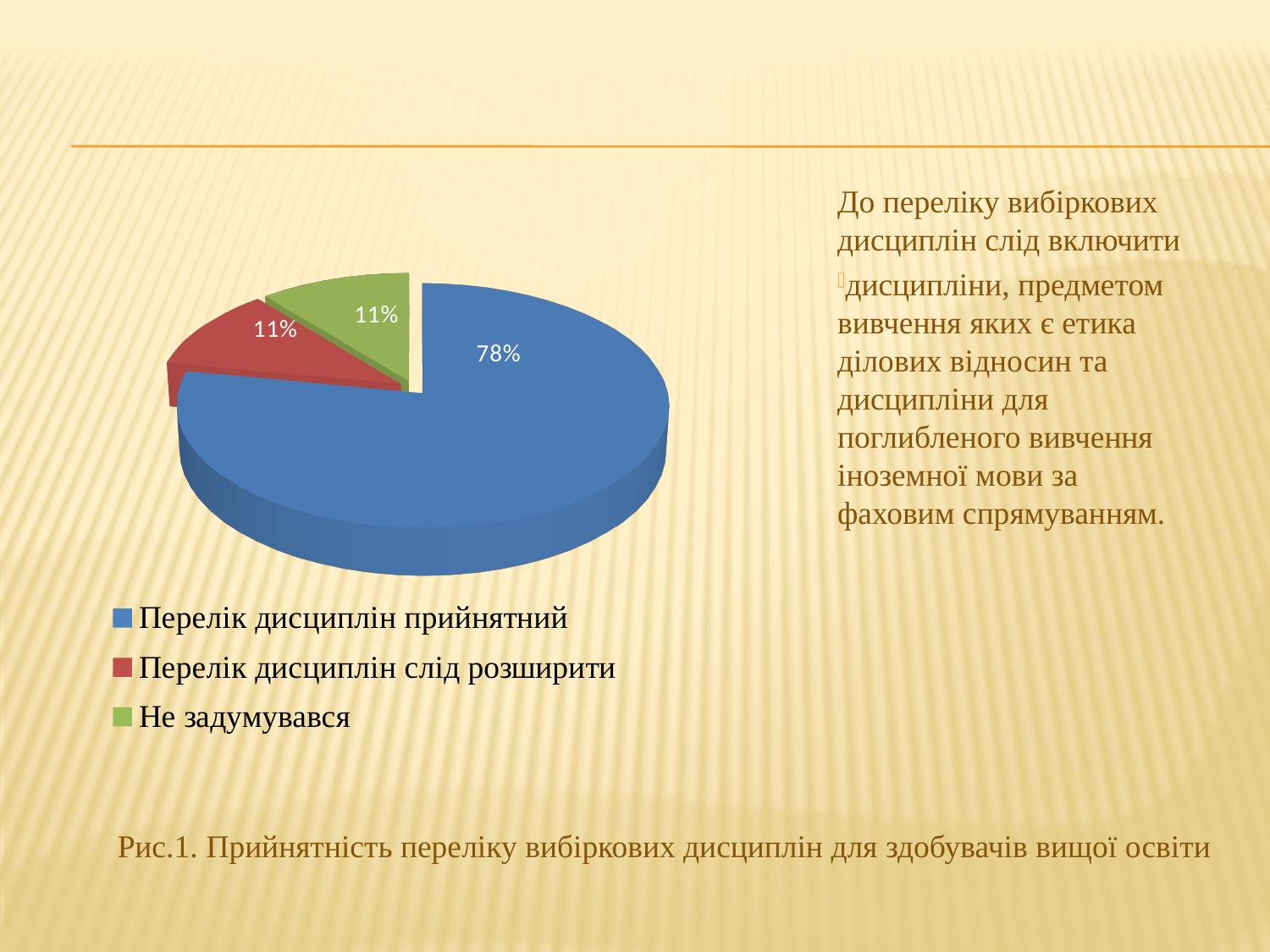
Is the share for "Перелік дисциплін прийнятний" greater or less than 50%? greater How many slices does the pie chart have? 3 Which is larger: the slice for "Перелік дисциплін прийнятний" or the slice for "Перелік дисциплін слід розширити"? Перелік дисциплін прийнятний What share of the pie does "Перелік дисциплін прийнятний" have? 78% By how many percentage points does "Перелік дисциплін прийнятний" exceed "Не задумувався"? 67 percentage points What colour is the slice for "Не задумувався"? Green What is the combined share of "Перелік дисциплін слід розширити" and "Не задумувався"? 22% What share of the pie does "Перелік дисциплін слід розширити" have? 11% Which category has the largest slice of the pie? Перелік дисциплін прийнятний What kind of chart is shown on the slide? Pie chart What is the figure caption of the chart? Рис.1. Прийнятність переліку вибіркових дисциплін для здобувачів вищої освіти What share of the pie does "Не задумувався" have? 11%